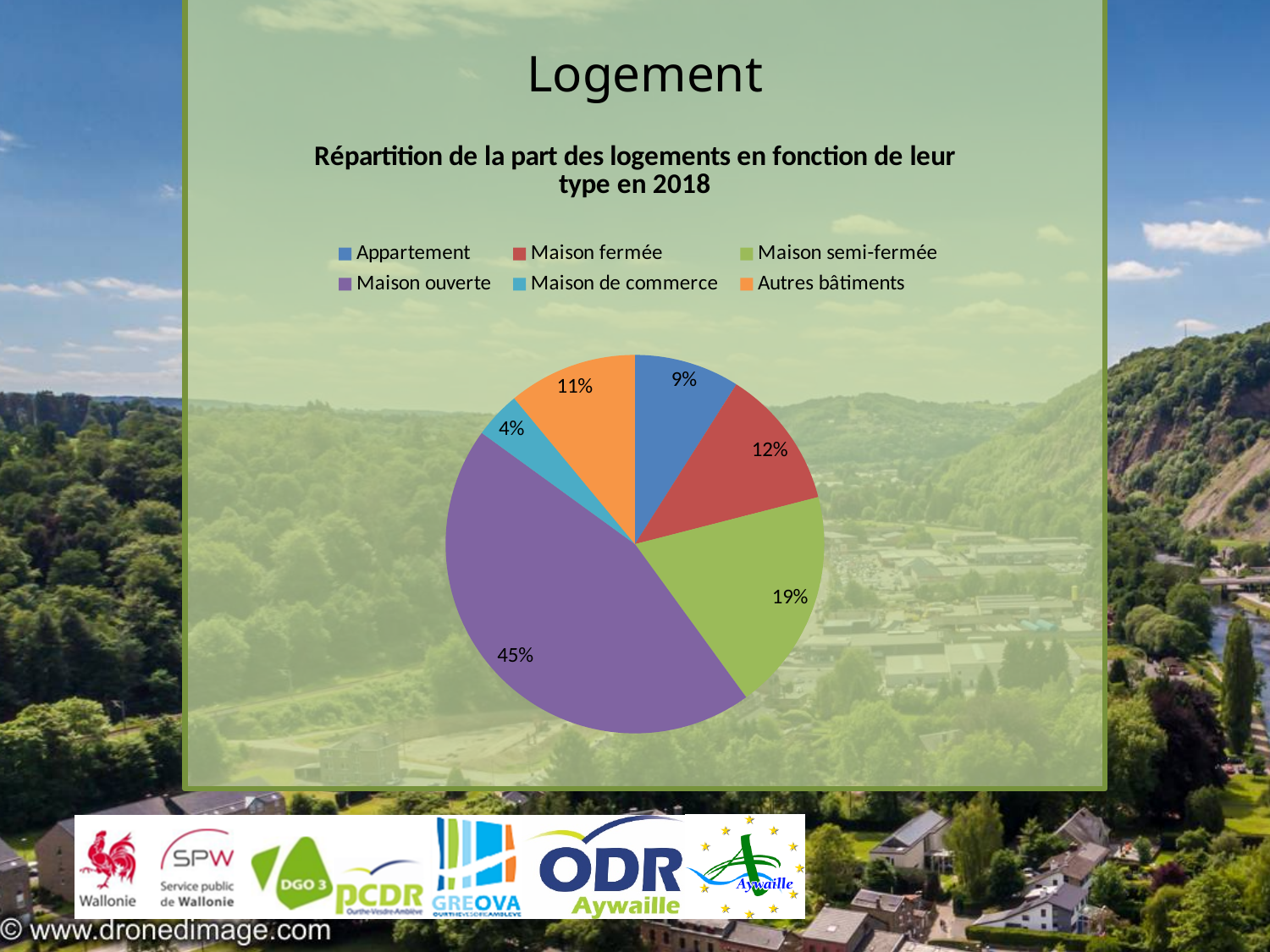
Which housing type has the smallest share of the pie? Maison de commerce What is the share for Maison de commerce? 4% What is the share for Appartement? 9% What is the share for Maison ouverte? 45% What is the title of the chart? Répartition de la part des logements en fonction de leur type en 2018 Which has a larger share, Maison fermée or Autres bâtiments? Maison fermée What type of chart is shown on the slide? Pie chart Which housing type has the largest share of the pie? Maison ouverte What is the share for Maison semi-fermée? 19% What is the share for Autres bâtiments? 11% What is the difference in percentage points between Maison ouverte and Maison semi-fermée? 26 How many categories does the legend list? 6